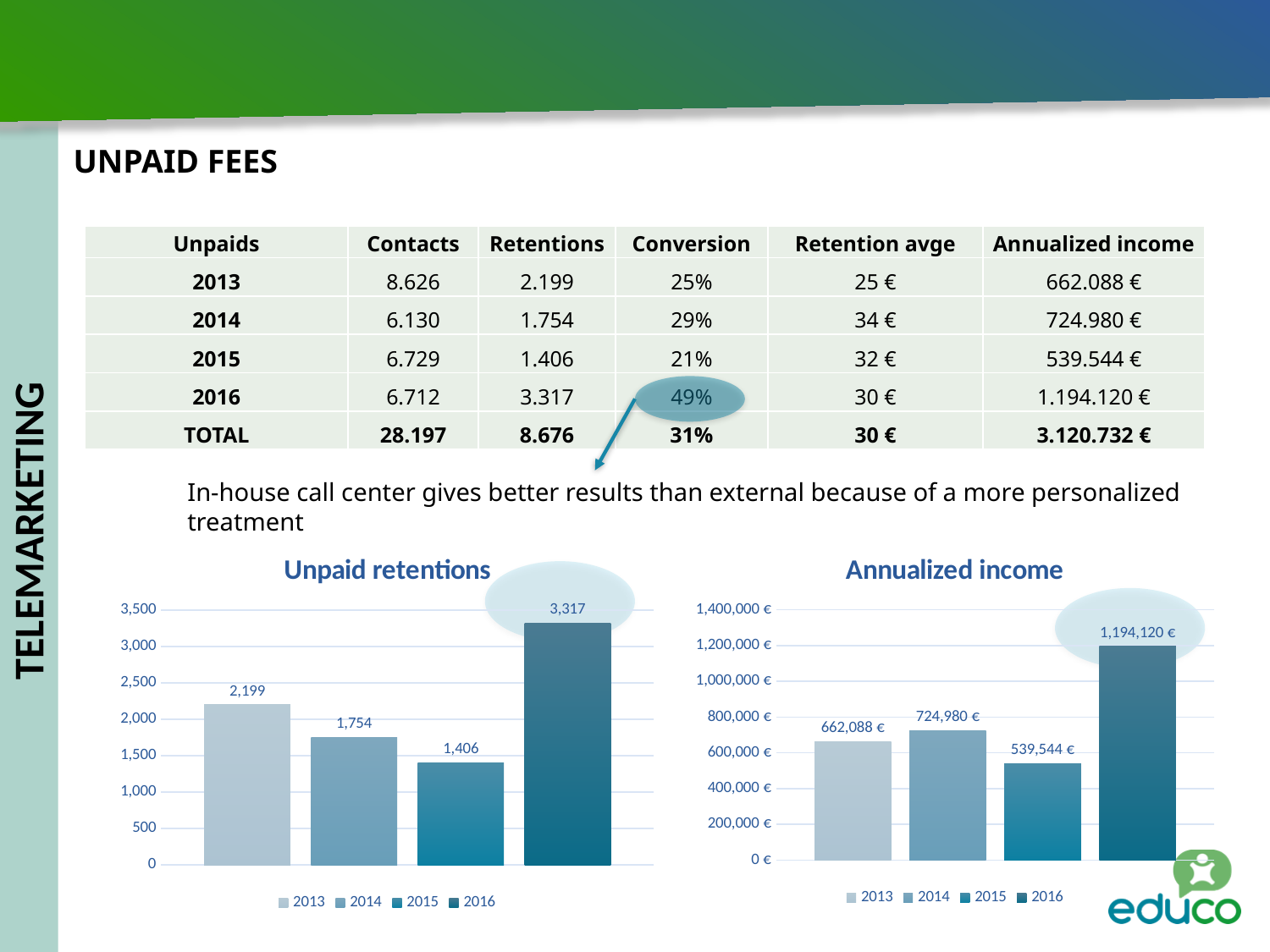
In the 'Annualized income' chart, which year has the lowest value? 2015 In the 'Unpaid retentions' chart, what is the difference between the values for 2013 and 2014? 445 In the 'Unpaid retentions' chart, what is the value for 2016? 3,317 How many entries does the legend of the 'Unpaid retentions' chart list? 4 In the 'Annualized income' chart, which is larger, the value for 2013 or the value for 2014? 2014 In the 'Annualized income' chart, how many bars are plotted? 4 What kind of chart is the 'Annualized income' chart? Bar chart In the 'Annualized income' chart, what is the value for 2014? 724,980 € In the 'Unpaid retentions' chart, what is the value for 2015? 1,406 In the 'Unpaid retentions' chart, which year has the lowest value? 2015 In the 'Unpaid retentions' chart, which year has the highest value? 2016 In the 'Annualized income' chart, what is the value for 2016? 1,194,120 €